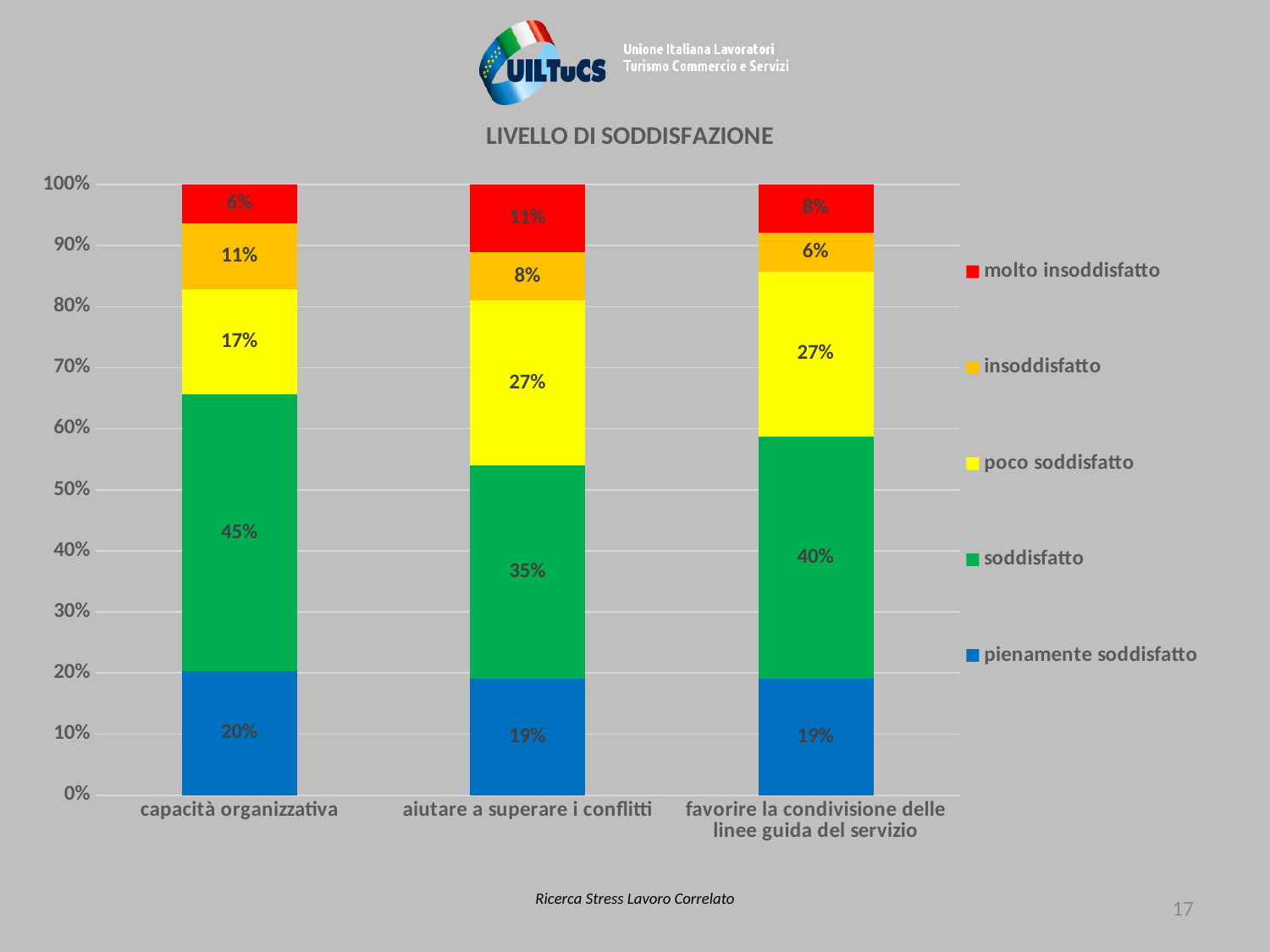
How many categories are shown on the x axis? 3 What kind of chart is shown on the slide? stacked bar chart Which category has the highest value for 'soddisfatto'? capacità organizzativa What is the title of the chart? LIVELLO DI SODDISFAZIONE What is the value for 'molto insoddisfatto' in the 'aiutare a superare i conflitti' bar? 11% What is the value for 'poco soddisfatto' in the 'favorire la condivisione delle linee guida del servizio' bar? 27% What is the difference between the 'soddisfatto' values for 'capacità organizzativa' and 'aiutare a superare i conflitti'? 10% How many series does the legend list? 5 Which is larger: the 'poco soddisfatto' value for 'capacità organizzativa' or for 'aiutare a superare i conflitti'? aiutare a superare i conflitti Which colour represents 'pienamente soddisfatto' in the legend? blue Which category has the lowest value for 'insoddisfatto'? favorire la condivisione delle linee guida del servizio What is the value for 'soddisfatto' in the 'capacità organizzativa' bar? 45%